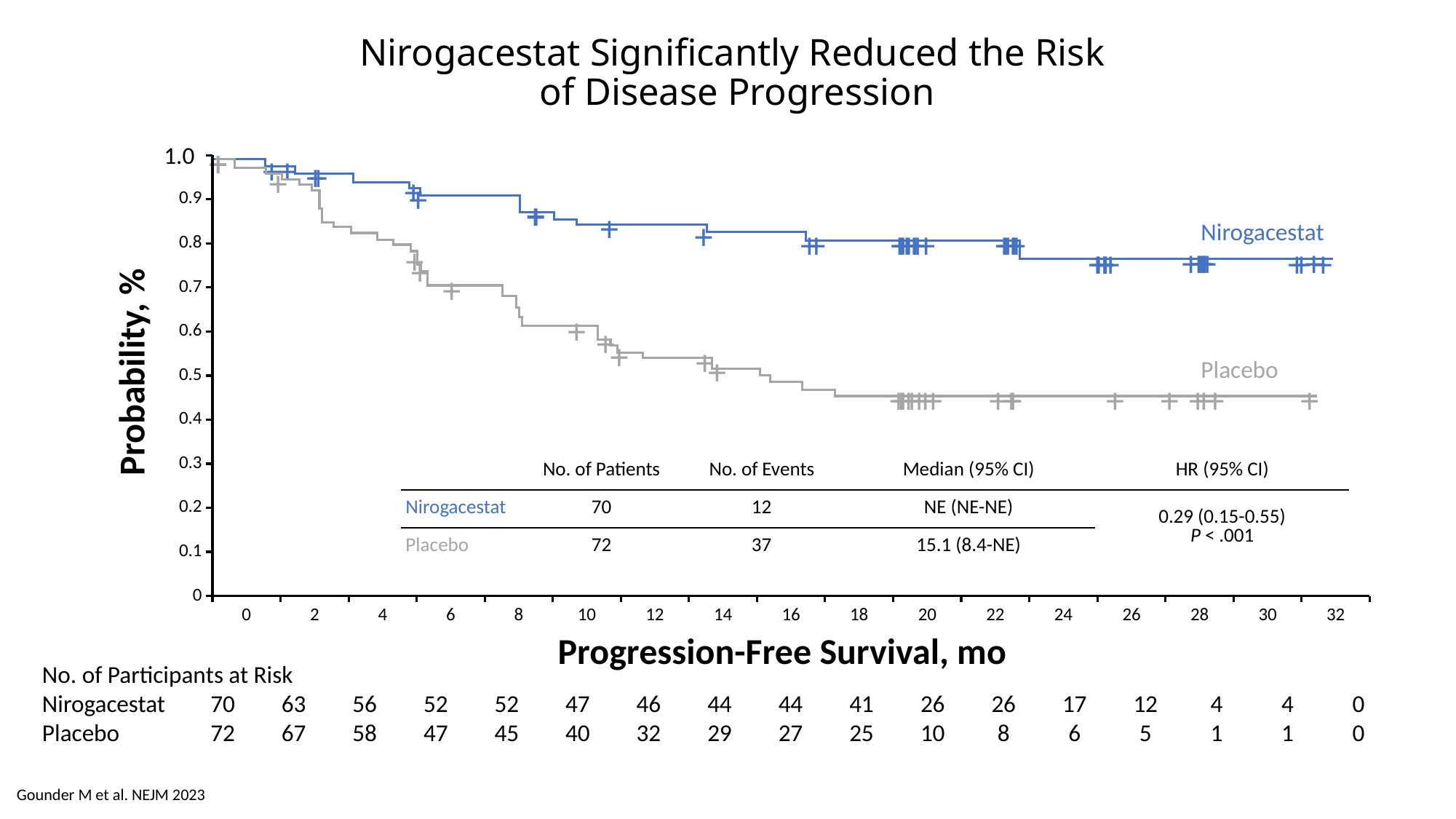
What is the number of events for the Placebo group shown in the table? 37 How many Nirogacestat participants were at risk at 24 months? 17 What is the hazard ratio (95% CI) reported on the chart? 0.29 (0.15-0.55) What is the median progression-free survival (95% CI) for the Placebo group? 15.1 (8.4-NE) How many Placebo participants were at risk at 20 months? 10 How many more events occurred in the Placebo group than in the Nirogacestat group? 25 How many treatment groups (series) are plotted on the chart? 2 What is the number of events for the Nirogacestat group shown in the table? 12 What kind of chart is shown on the slide? line chart (Kaplan-Meier survival curve) Do the survival probability curves rise or fall as progression-free survival time increases? fall Is the Placebo probability at 20 months greater or less than 0.5? less At 20 months, which curve shows the higher probability, Nirogacestat or Placebo? Nirogacestat